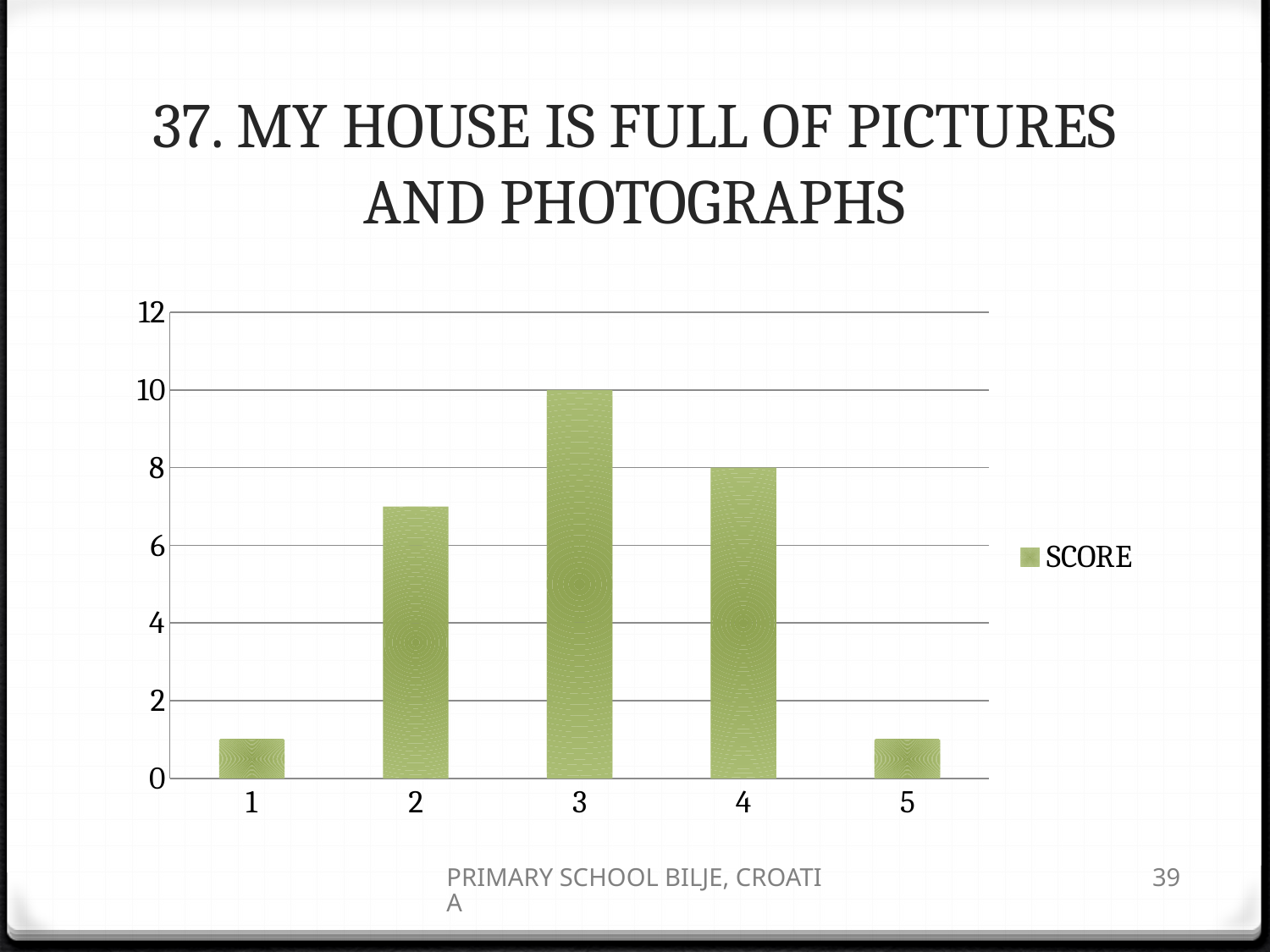
What is the difference between the values for category 3 and category 4? 2 What kind of chart is shown on the slide? bar chart What is the value for category 3? 10 What is the value for category 4? 8 Is the value for category 5 greater or less than 2? less What is the name of the series shown in the legend? SCORE How many series does the legend list? 1 Is the value for category 2 greater or less than 6? greater Which category has the highest value? 3 How many categories are shown on the x axis? 5 Which has a larger value, category 2 or category 4? 4 Is the value for category 1 greater or less than 2? less